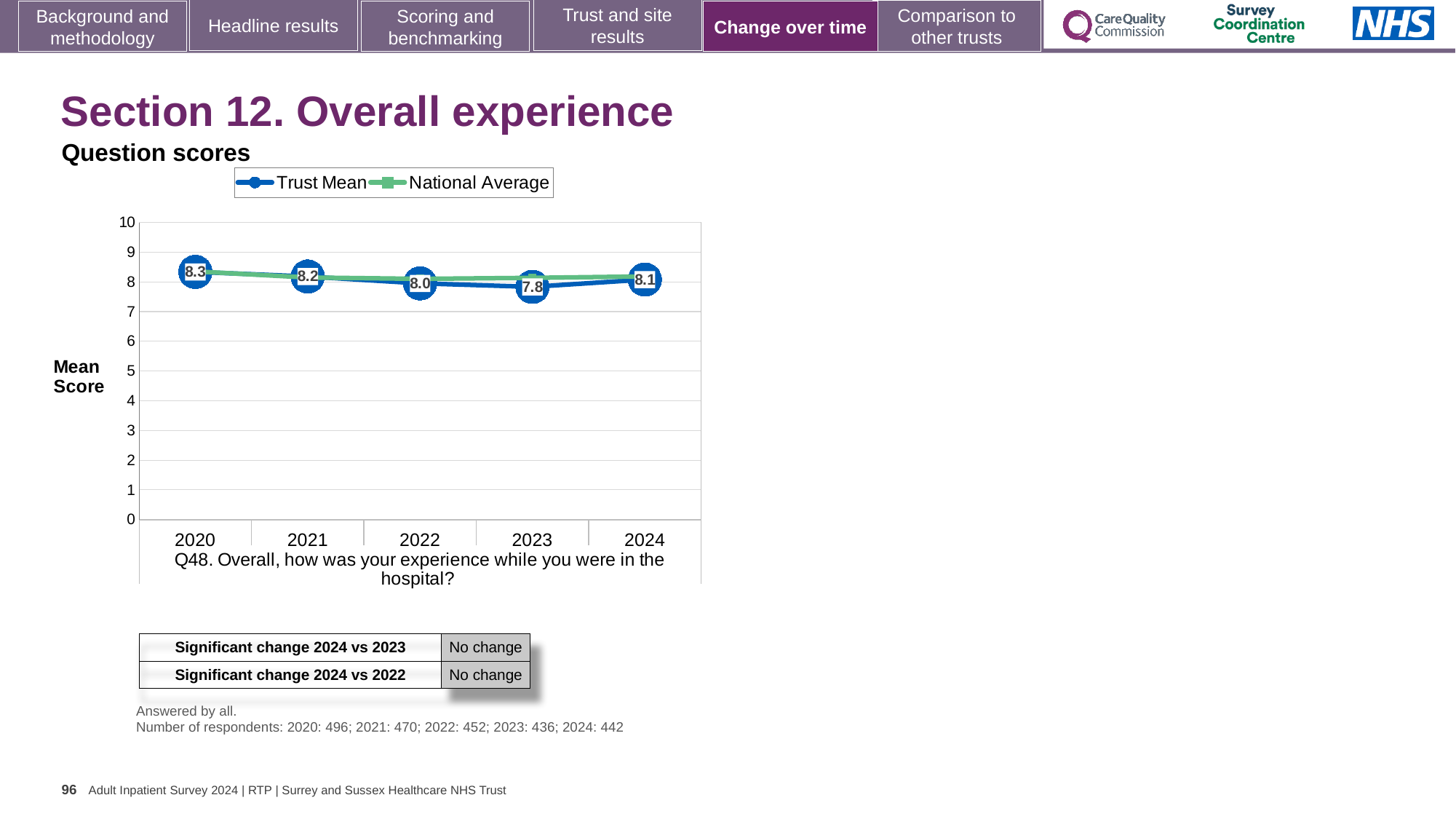
How many series does the legend list? 2 In which year is the Trust Mean score highest? 2020 In which year is the Trust Mean score lowest? 2023 What kind of chart is shown? Line chart Is the Trust Mean score for 2022 greater or less than 5? greater What is the Trust Mean score for 2023? 7.8 What is the Trust Mean score for 2024? 8.1 How many years are plotted on the x axis? 5 Does the Trust Mean score rise or fall from 2020 to 2023? Fall Which is larger, the Trust Mean score for 2021 or for 2022? 2021 What is the Trust Mean score for 2020? 8.3 What is the difference between the Trust Mean scores for 2020 and 2023? 0.5